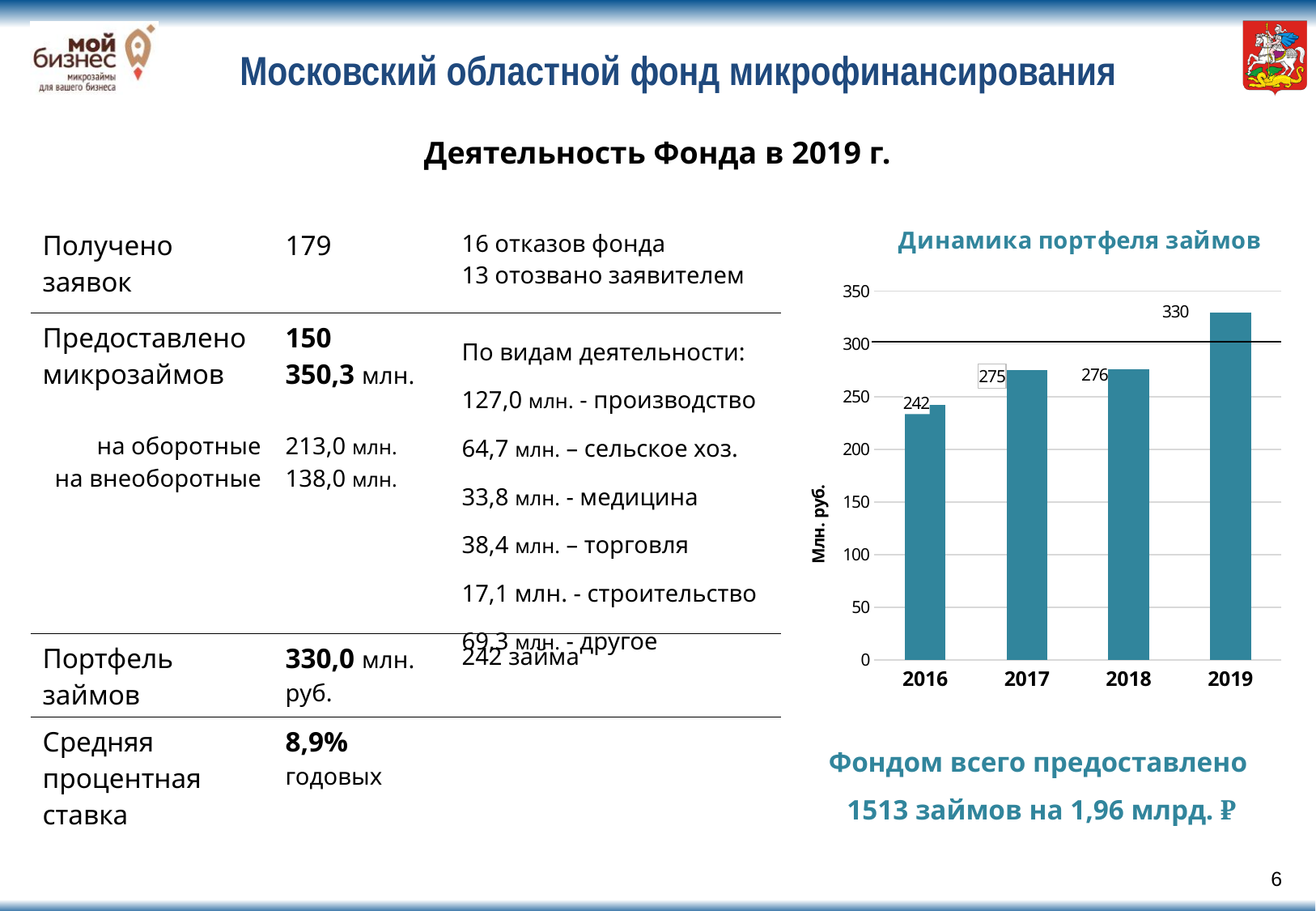
Which year has the highest value in the "Динамика портфеля займов" chart? 2019 What is the value for 2018 in the "Динамика портфеля займов" chart? 276 Do the values in the "Динамика портфеля займов" chart rise or fall from 2016 to 2019? rise What is the value for 2016 in the "Динамика портфеля займов" chart? 242 What is the value for 2017 in the "Динамика портфеля займов" chart? 275 What type of chart is shown under the title "Динамика портфеля займов"? bar chart How many years (categories) are shown in the "Динамика портфеля займов" chart? 4 Which year has the lowest value in the "Динамика портфеля займов" chart? 2016 What is the value for 2019 in the "Динамика портфеля займов" chart? 330 In the "Динамика портфеля займов" chart, which is larger: the value for 2017 or the value for 2019? 2019 What is the label of the vertical axis in the "Динамика портфеля займов" chart? Млн. руб. In the "Динамика портфеля займов" chart, what is the difference between the values for 2019 and 2016? 88